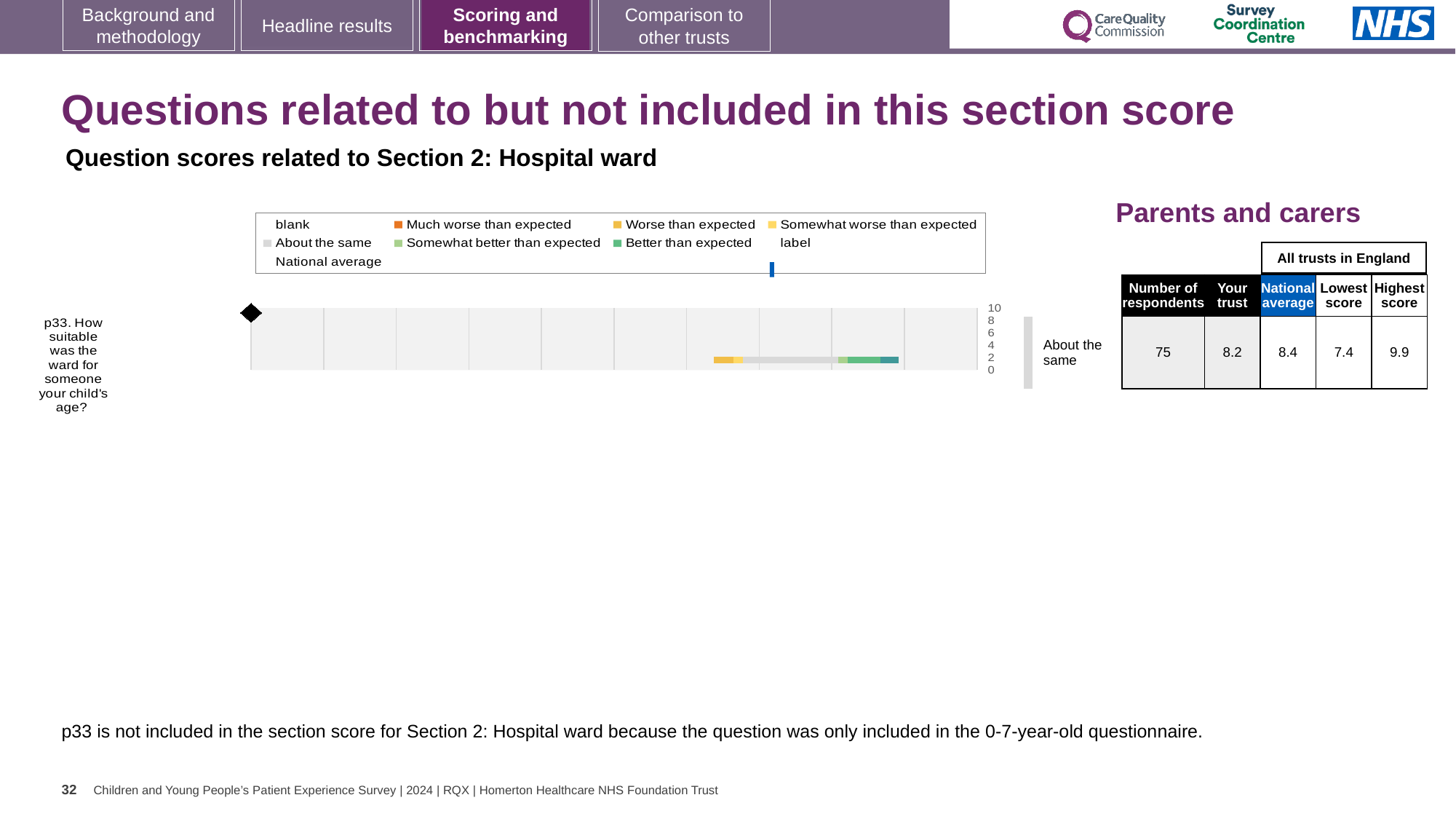
For p33, what is the difference between the highest score and the lowest score in the table? 2.5 For p33, what is the difference between the national average and the 'Your trust' score? 0.2 What benchmark category label is shown to the right of the bar for p33? About the same Which question is plotted in the chart? p33. How suitable was the ward for someone your child's age? According to the table, what is the 'Your trust' score for p33? 8.2 According to the table, what is the lowest score among all trusts in England for p33? 7.4 For p33, which is larger: the 'Your trust' score or the national average? National average What kind of chart is shown on the slide for question p33? bar chart How many questions are plotted in the chart? 1 According to the table, what is the highest score among all trusts in England for p33? 9.9 According to the table, how many respondents answered p33? 75 According to the table, what is the national average score for p33? 8.4